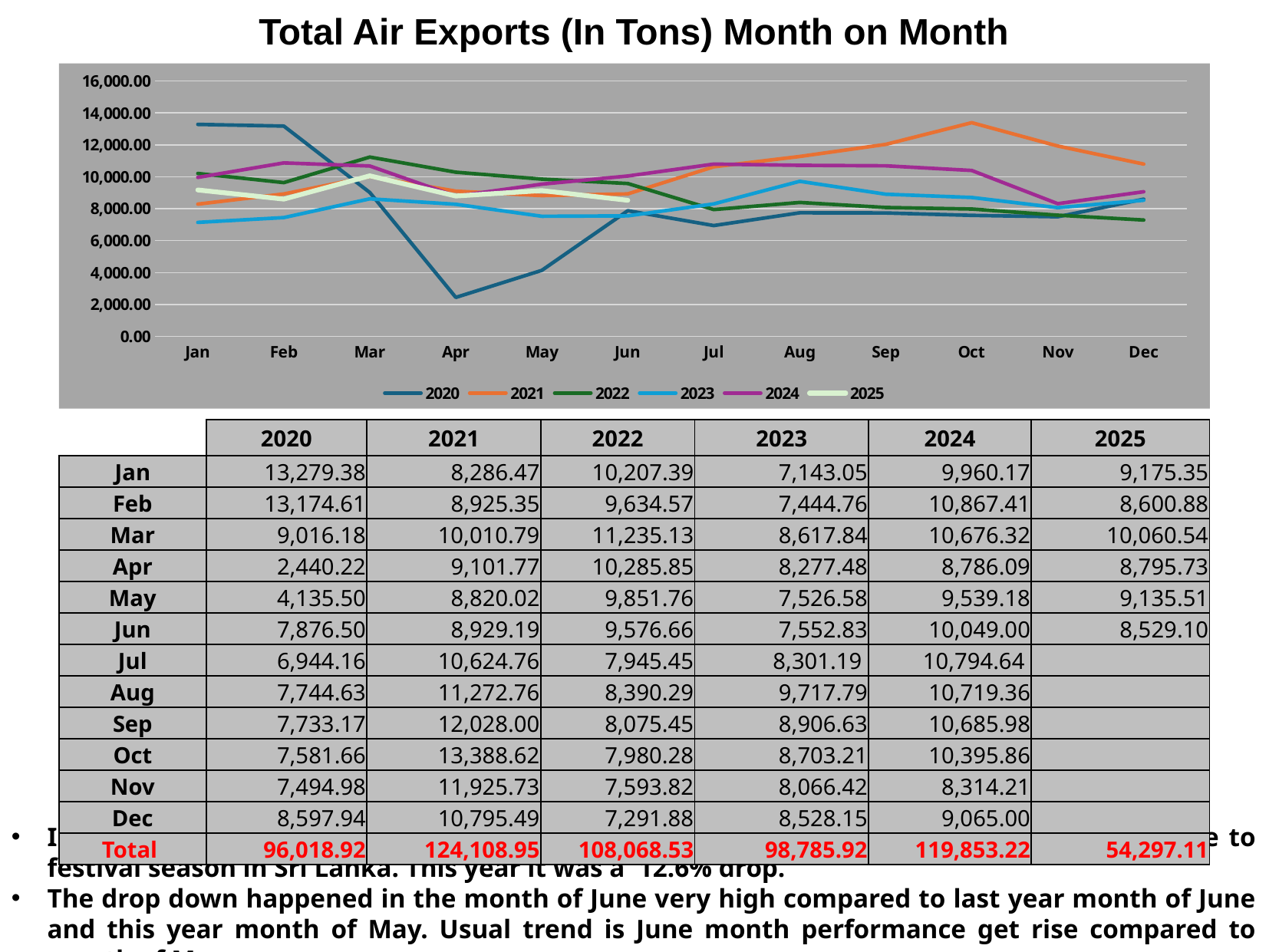
In which month does the 2020 series reach its lowest value? Apr What is the difference between the Jun value for 2024 and the Jun value for 2025? 1,519.90 What is the value for 2020 in Apr? 2,440.22 What is the value for 2021 in Oct? 13,388.62 Which series has the larger value in Mar, 2022 or 2024? 2022 What is the title of the chart? Total Air Exports (In Tons) Month on Month In which month does the 2021 series reach its highest value? Oct Is the value for 2020 in Jan greater or less than 12,000.00? greater How many series does the chart legend list? 6 How many months are plotted along the x axis of the chart? 12 Does the 2020 series rise or fall from Jan to Apr? fall What kind of chart is shown on the slide? line chart